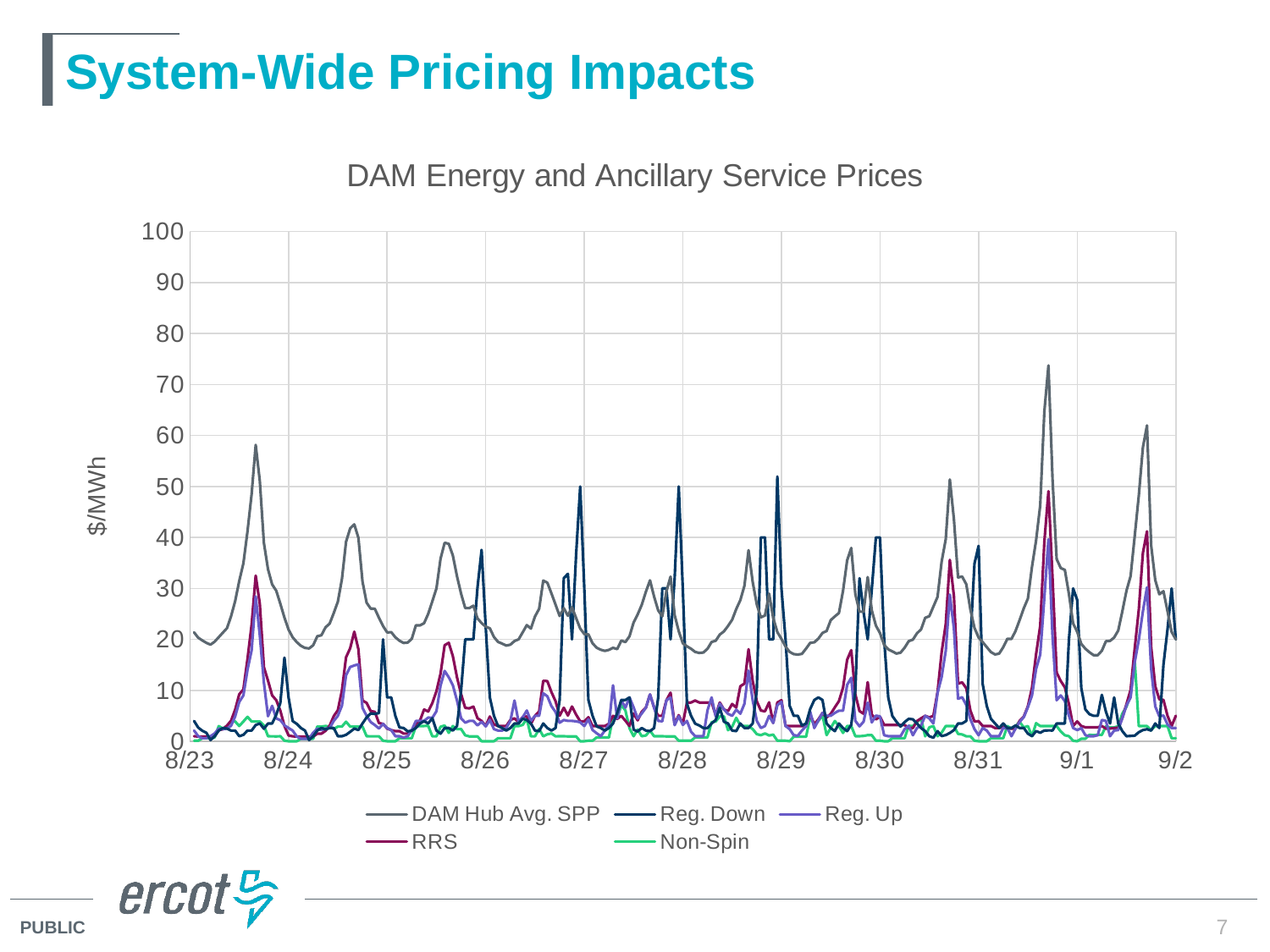
Which series reaches the highest value anywhere on the chart? DAM Hub Avg. SPP Which series stays lowest across most of the chart? Non-Spin What is the label on the vertical axis? $/MWh Is the highest value of Non-Spin greater or less than 20? less Which series has the higher peak near 9/1, DAM Hub Avg. SPP or Reg. Up? DAM Hub Avg. SPP What kind of chart is shown on the slide? line chart How many series does the legend list? 5 Is the highest peak of DAM Hub Avg. SPP greater or less than 60? greater Is the highest peak of Reg. Down greater or less than 40? greater What is the title of the chart? DAM Energy and Ancillary Service Prices How many date labels are shown along the x axis? 11